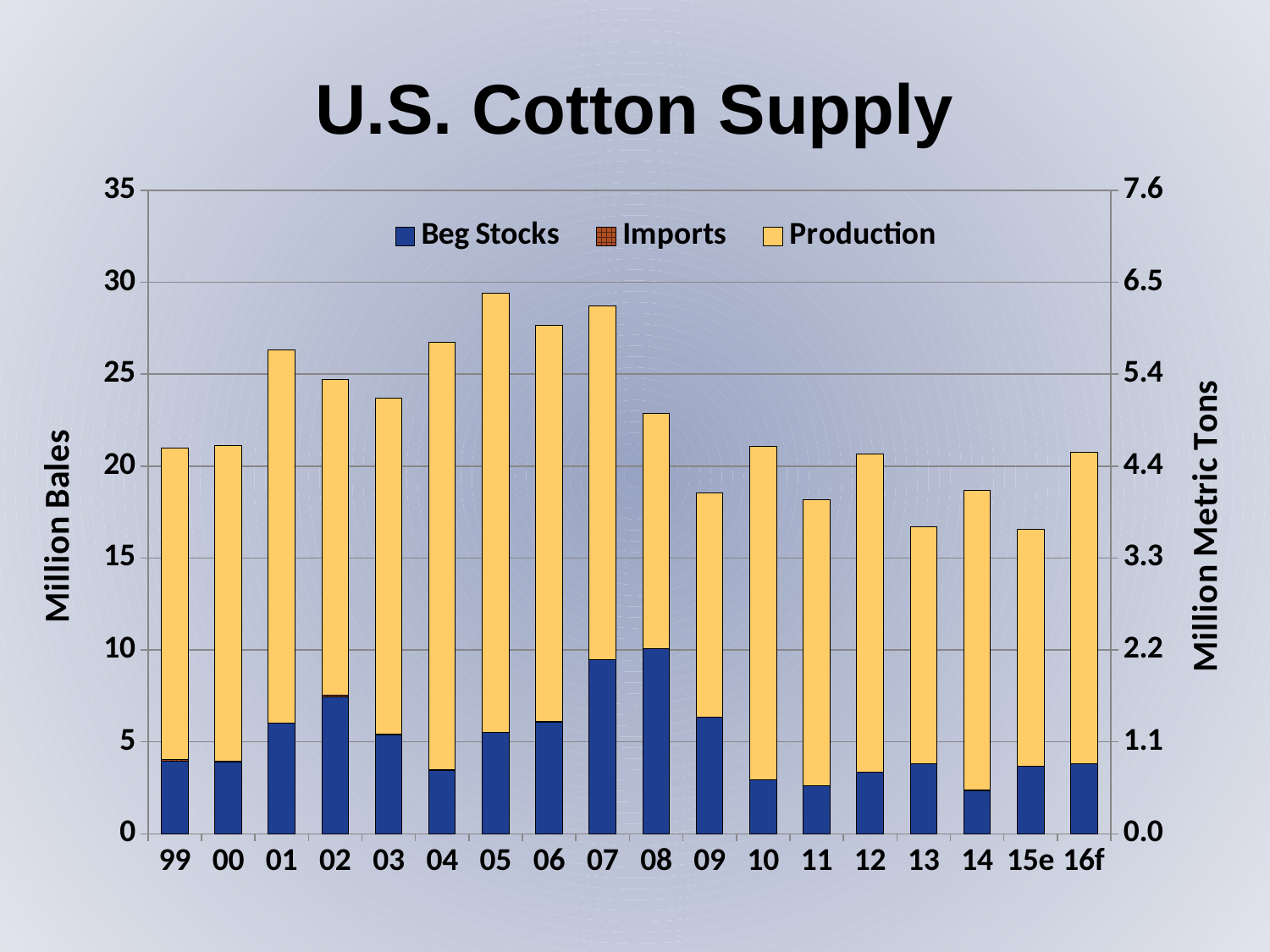
What is the title of the chart? U.S. Cotton Supply Is the total supply for 05 greater or less than 25 million bales? greater Is the Beg Stocks value for 08 greater or less than 5 million bales? greater What is the label of the right-hand vertical axis? Million Metric Tons Which year has the larger total supply, 01 or 02? 01 Which year has the highest Beg Stocks value? 08 Is the total supply for 13 greater or less than 20 million bales? less What kind of chart is shown on the slide? Stacked bar chart How many series does the legend list? 3 How many years (categories) are shown on the x axis? 18 Which year has the highest total U.S. cotton supply? 05